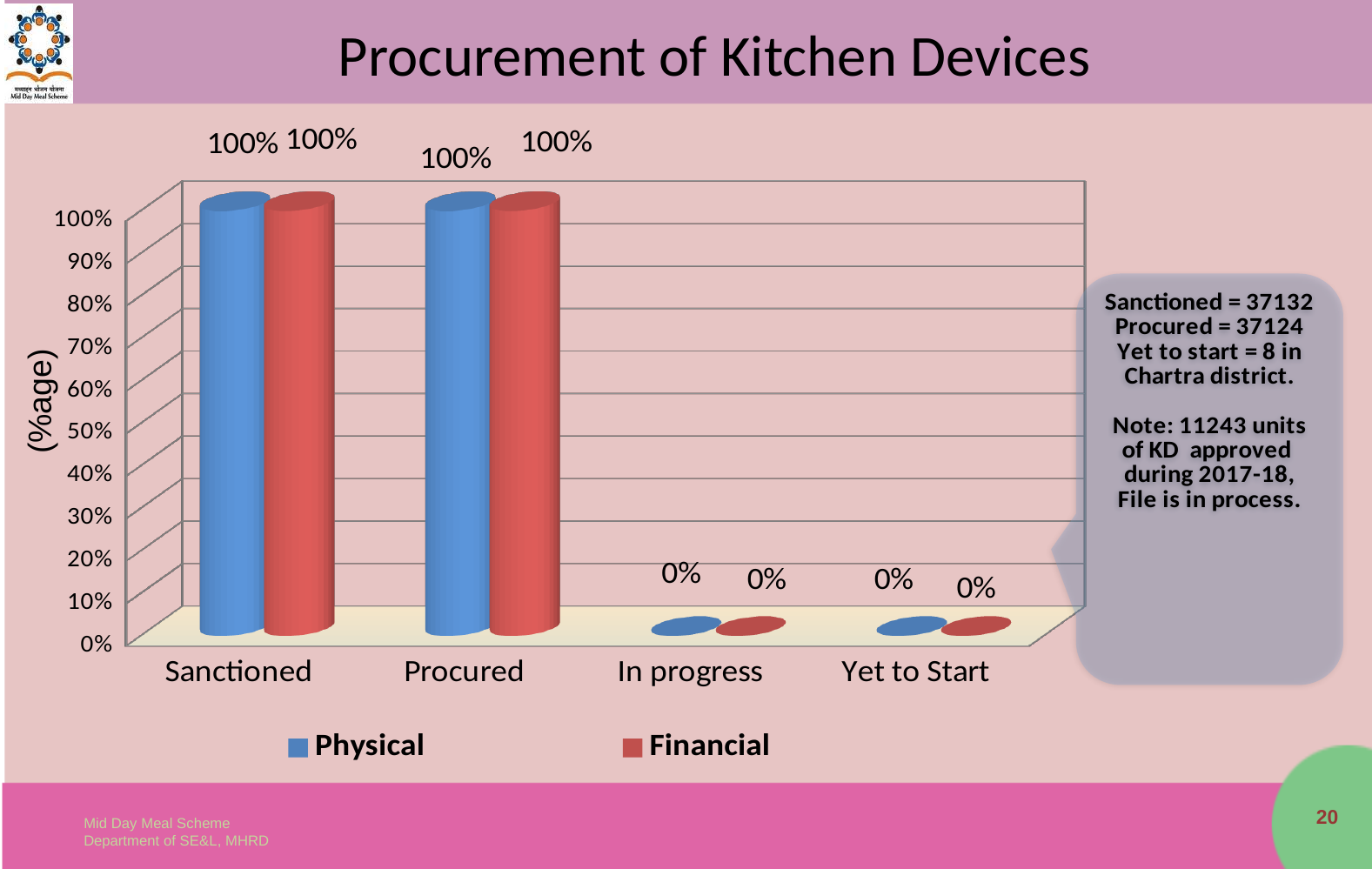
What is the Physical value for Sanctioned? 100% Is the Physical value for Procured greater or less than 50%? greater How many categories are shown on the x axis? 4 What is the Physical value for In progress? 0% What is the difference between the Financial value for Sanctioned and the Financial value for In progress? 100% What is the Financial value for Yet to Start? 0% What is the title of the chart? Procurement of Kitchen Devices Which series is shown in red in the legend? Financial What kind of chart is shown on the slide? bar chart How many series does the legend list? 2 Which is larger, the Physical value for Procured or the Physical value for Yet to Start? Procured What is the Financial value for Procured? 100%